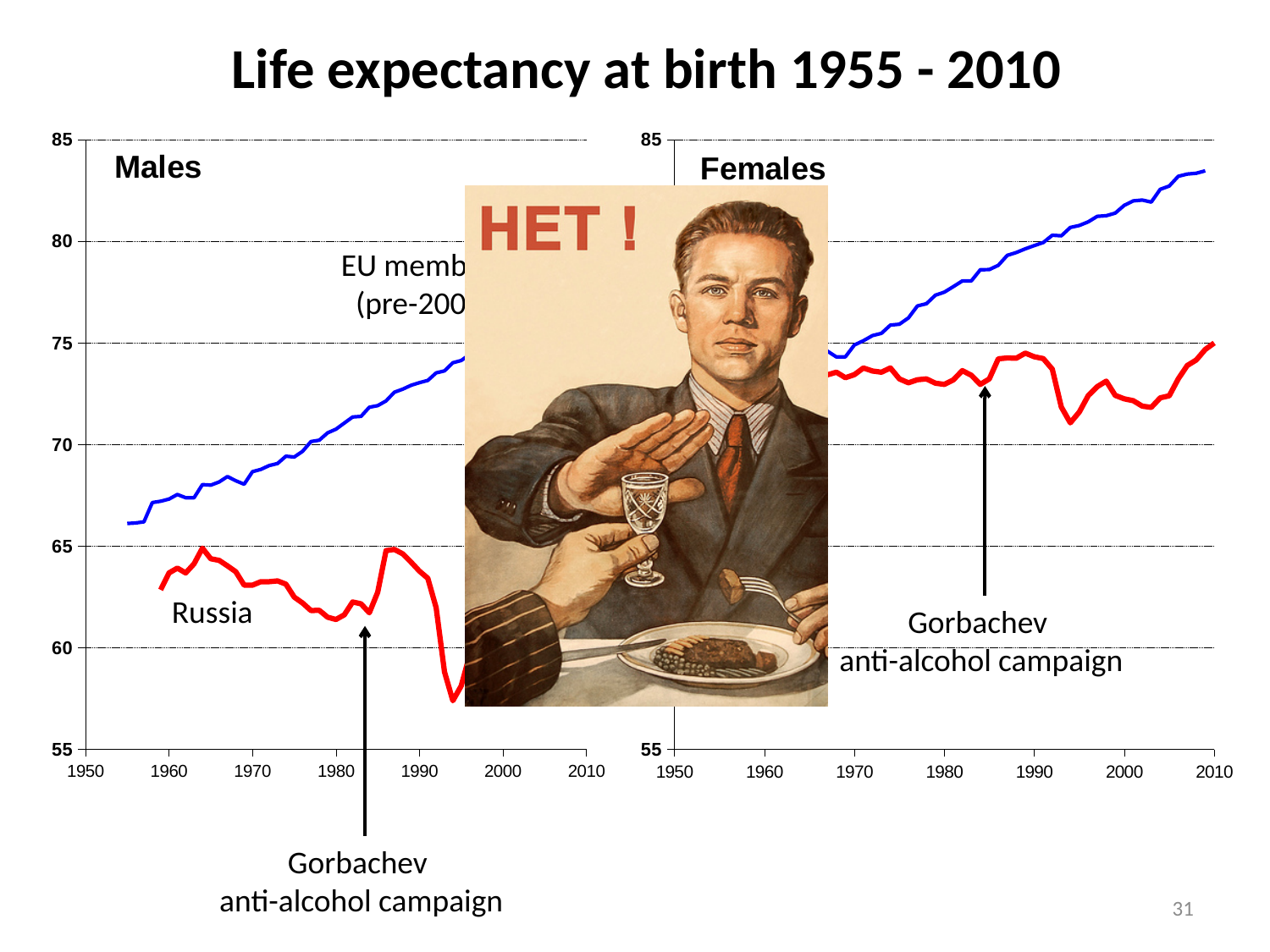
In the Females chart, is the value for the blue line in 2010 greater or less than 80? greater In the Males chart, is the value for Russia in 1960 greater or less than 65? less In the Females chart, does the blue line rise or fall from 1955 to 2010? rise In the Males chart, is the value for the blue line in 1960 greater or less than 65? greater What kind of chart is the Males chart on the left? line chart In the Males chart, which series is plotted higher throughout, the blue line or the red Russia line? the blue line What is the title of the slide's charts? Life expectancy at birth 1955 - 2010 How many lines are plotted in the Females chart? 2 What event do the arrows on both charts point to? Gorbachev anti-alcohol campaign